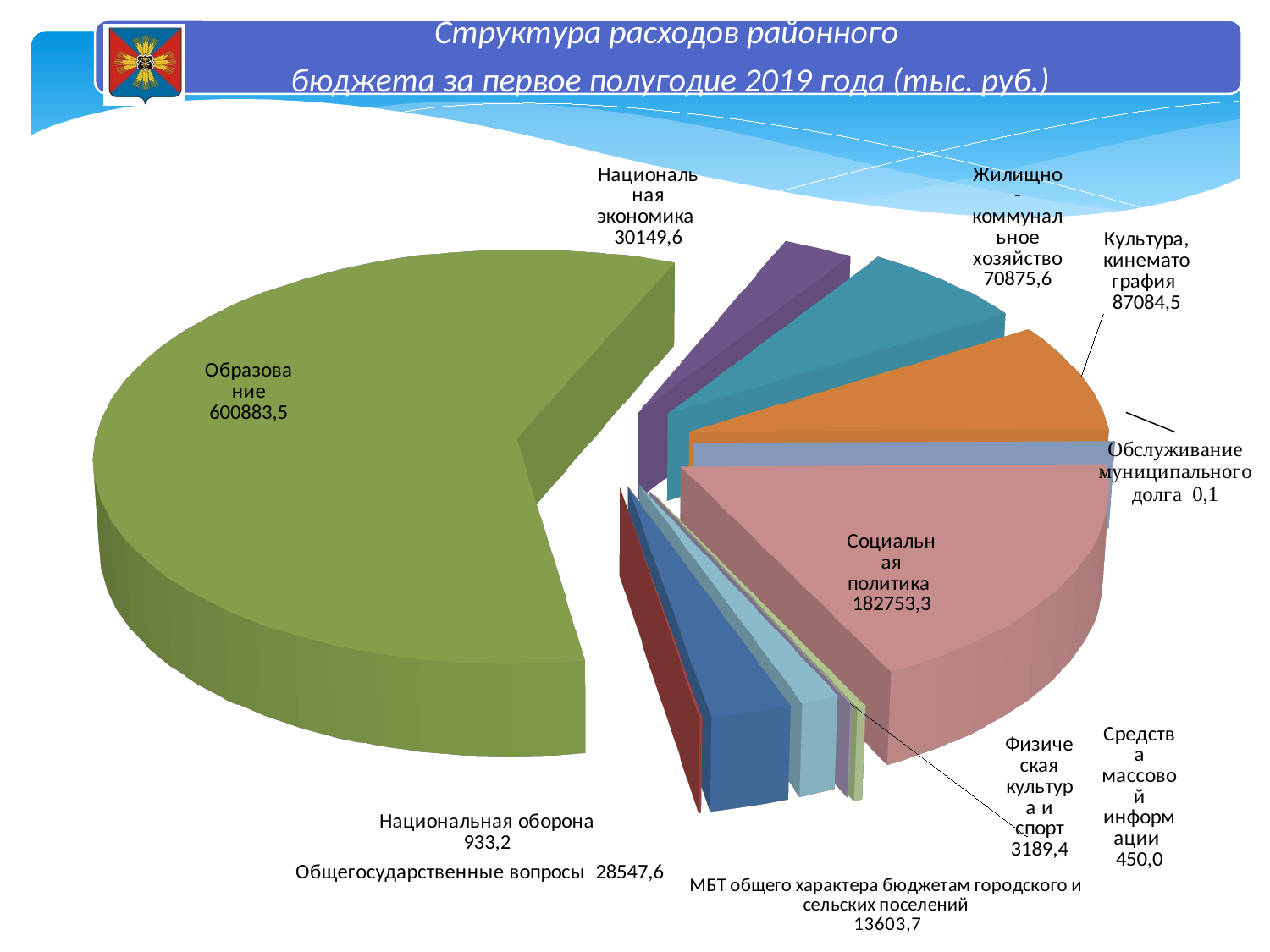
Which category has the largest value? Образование What is the value for Жилищно-коммунальное хозяйство? 70875,6 What is the title of the chart? Структура расходов районного бюджета за первое полугодие 2019 года (тыс. руб.) What type of chart is shown on the slide? pie chart Which category has the smallest value? Обслуживание муниципального долга What is the value for Обслуживание муниципального долга? 0,1 What is the difference between Культура, кинематография and Жилищно-коммунальное хозяйство? 16208,9 What is the value for Социальная политика? 182753,3 How many categories does the pie chart show? 11 What is the difference between Образование and Социальная политика? 418130,2 What is the value for Образование? 600883,5 Which is larger, Национальная экономика or Общегосударственные вопросы? Национальная экономика